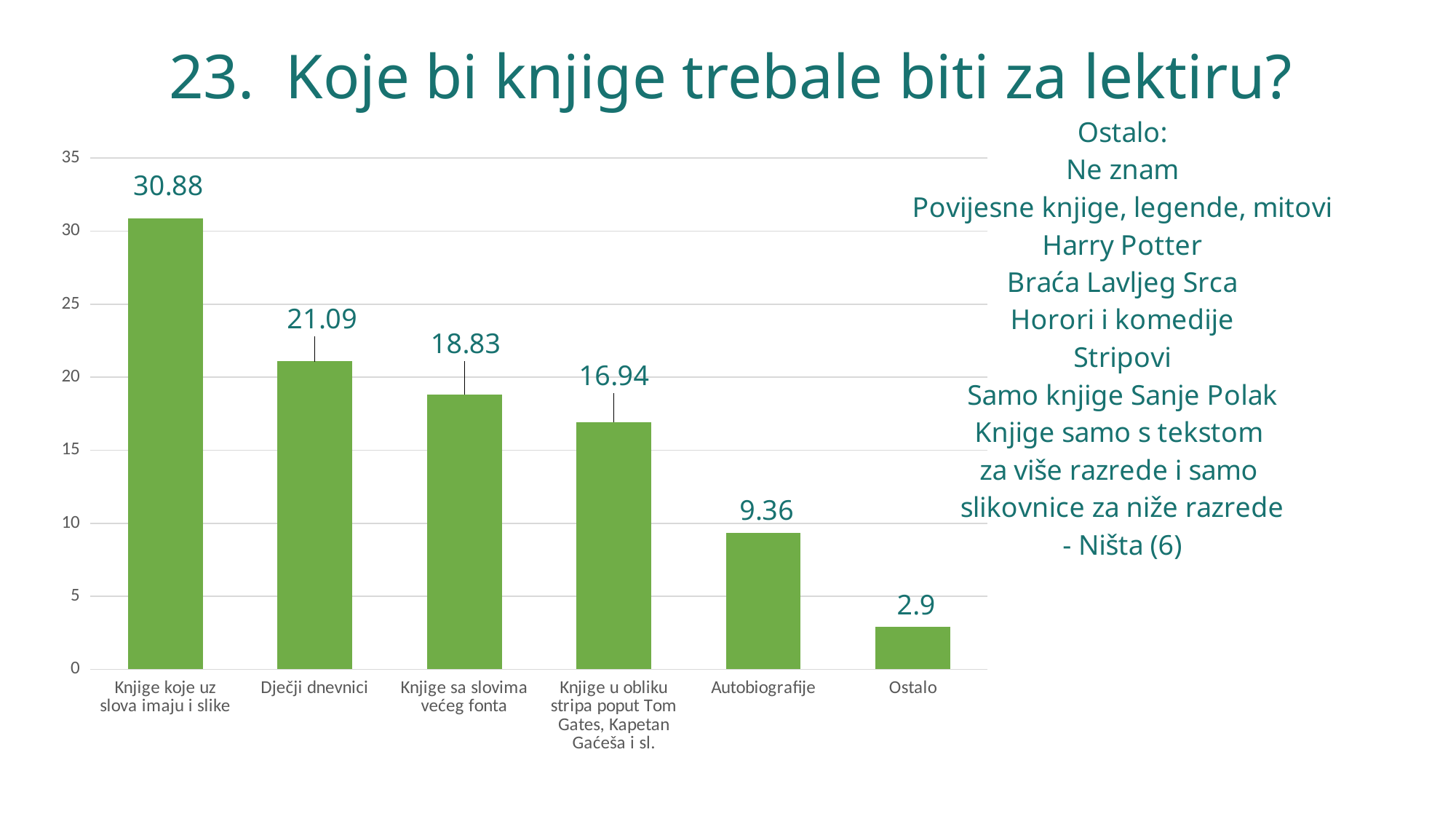
What is the value for Dječji dnevnici? 21.09 What is the value for Knjige sa slovima većeg fonta? 18.83 Which category has the highest value? Knjige koje uz slova imaju i slike What kind of chart is shown on the slide? bar chart Which category has the lowest value? Ostalo What is the difference between the values for Knjige koje uz slova imaju i slike and Dječji dnevnici? 9.79 Do the values rise or fall from left to right along the x axis? fall Which is larger, the value for Knjige sa slovima većeg fonta or the value for Knjige u obliku stripa poput Tom Gates, Kapetan Gaćeša i sl.? Knjige sa slovima većeg fonta What is the value for Autobiografije? 9.36 How many categories are shown in the chart? 6 Is the value for Autobiografije greater or less than 10? less What is the value for Ostalo? 2.9